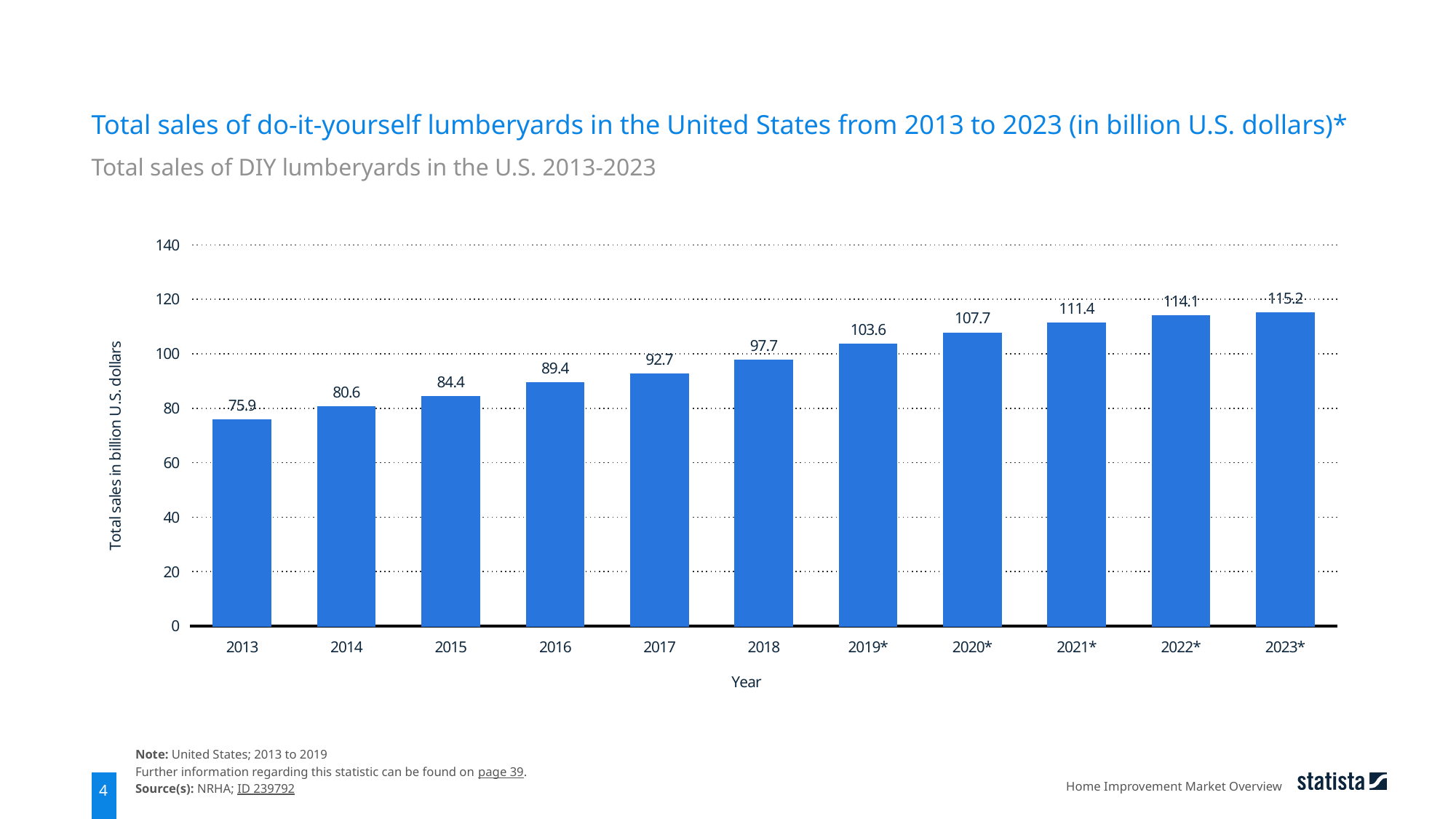
How many years are shown on the x axis? 11 Do the values rise or fall from 2013 to 2023*? rise What is the projected value for 2021*? 111.4 What kind of chart is shown on the slide? bar chart What is the difference between the values for 2023* and 2013? 39.3 What were the total sales of DIY lumberyards in the U.S. in 2013? 75.9 Which year has the highest total sales? 2023* Which year has the lowest total sales? 2013 Is the value for 2020* greater or less than 100? greater What value is shown for 2018? 97.7 Which is larger, the value for 2017 or the value for 2019*? 2019* What is the difference between the values for 2016 and 2015? 5